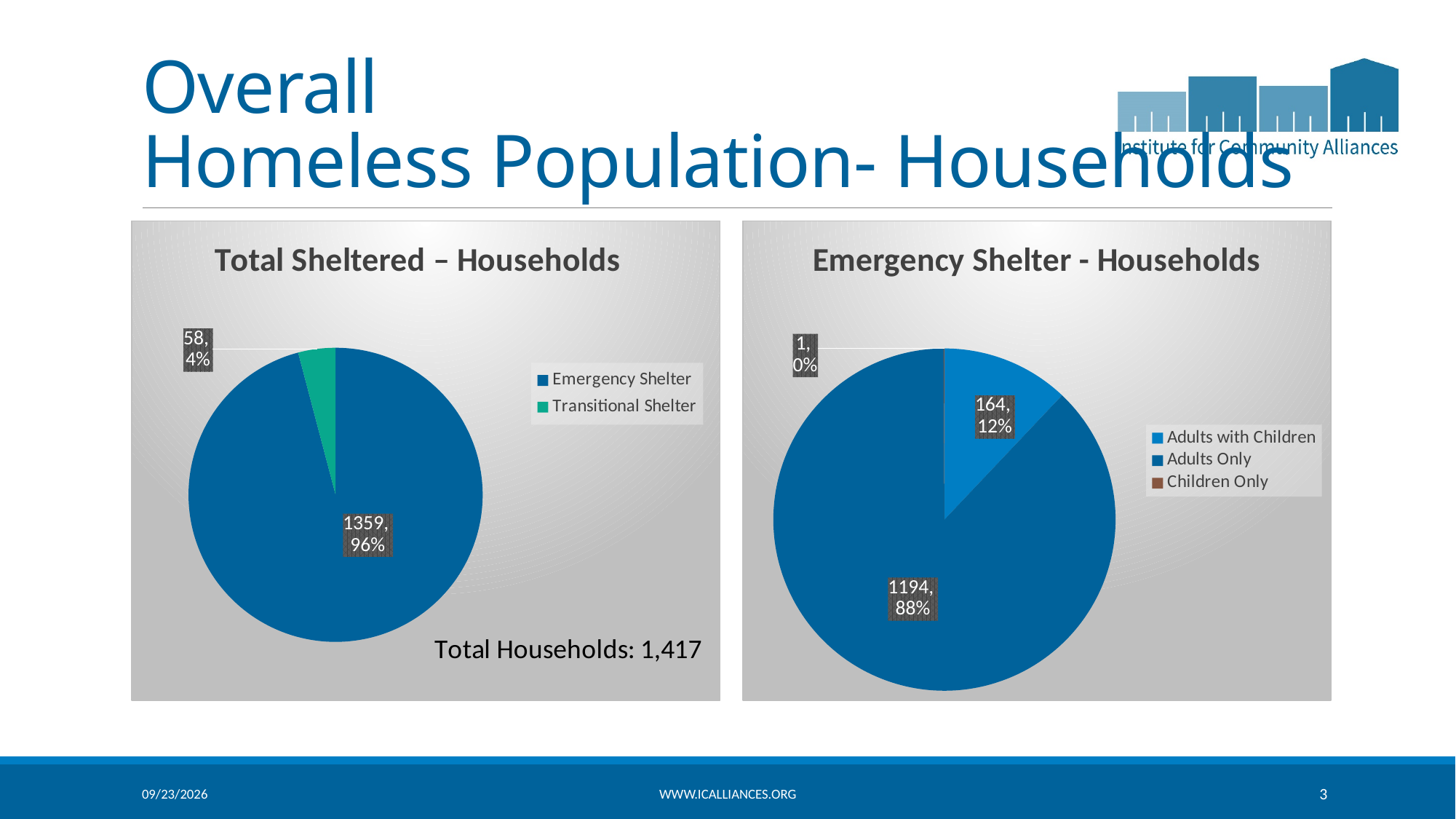
In the 'Emergency Shelter - Households' chart, what value is shown for Adults Only? 1194 In the 'Total Sheltered – Households' chart, what value is shown for Transitional Shelter? 58 What type of chart is the 'Emergency Shelter - Households' chart? Pie chart What total number of households is stated on the 'Total Sheltered – Households' chart? 1,417 In the 'Total Sheltered – Households' chart, how many series does the legend list? 2 In the 'Emergency Shelter - Households' chart, which category has the smallest value? Children Only In the 'Total Sheltered – Households' chart, what is the difference between the Emergency Shelter and Transitional Shelter values? 1301 In the 'Emergency Shelter - Households' chart, which is larger, Adults Only or Adults with Children? Adults Only In the 'Emergency Shelter - Households' chart, what share of the pie is Adults with Children? 12% In the 'Total Sheltered – Households' chart, what share of the pie is Emergency Shelter? 96% In the 'Total Sheltered – Households' chart, what value is shown for Emergency Shelter? 1359 In the 'Emergency Shelter - Households' chart, what value is shown for Adults with Children? 164